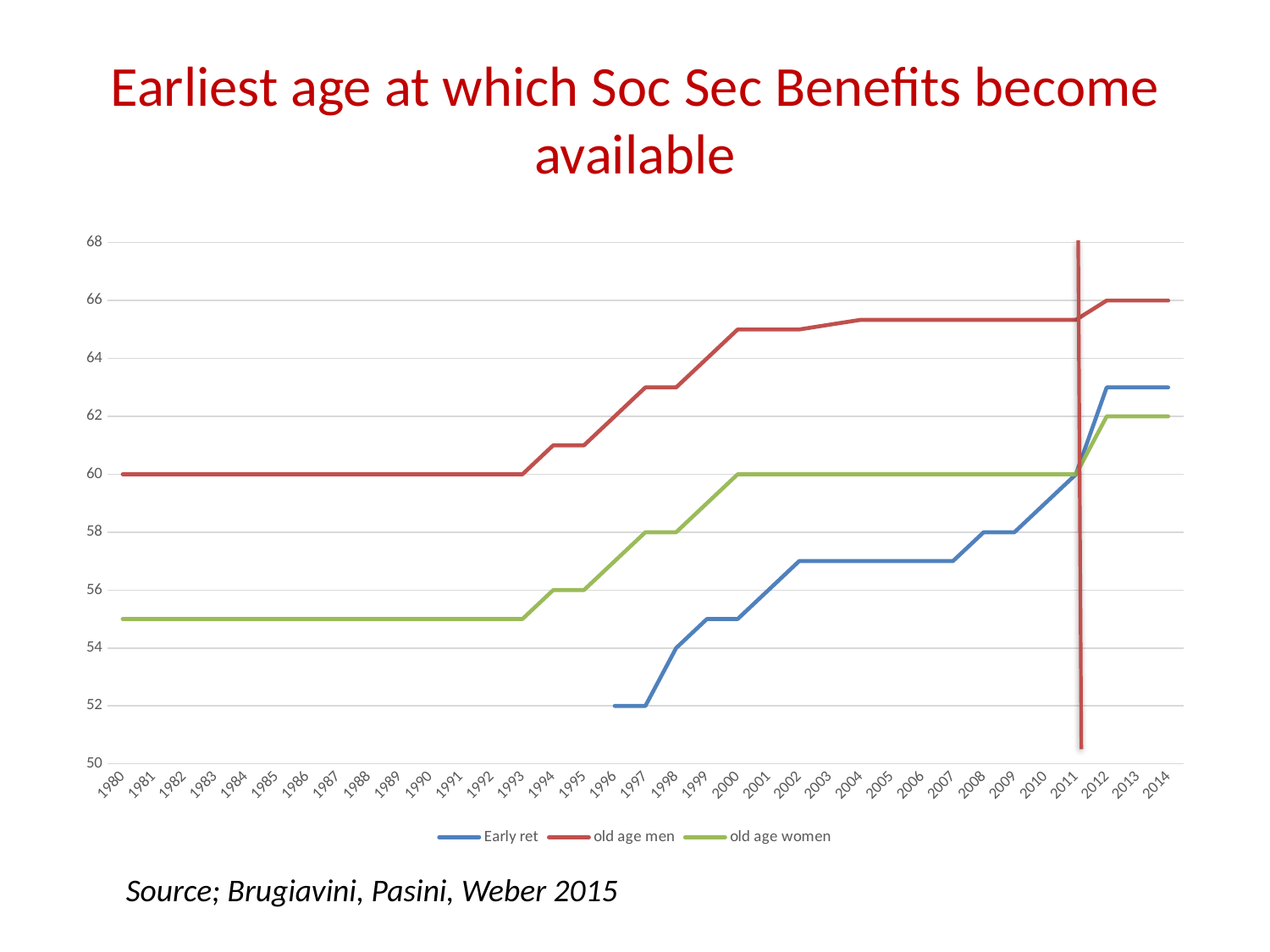
What is the value for old age men in 2014? 66 How many series does the legend list? 3 What is the value for Early ret in 2008? 58 Is the value for old age women in 1985 greater or less than 56? less What is the value for Early ret in 1996? 52 Which series has the highest value in 2014? old age men What is the difference between old age men and old age women in 2014? 4 Is the value for Early ret in 2014 greater or less than 62? greater What is the value for old age women in 2013? 62 What kind of chart is shown on the slide? line chart Does the old age men series rise or fall from 1980 to 2014? rise What is the value for old age men in 1980? 60